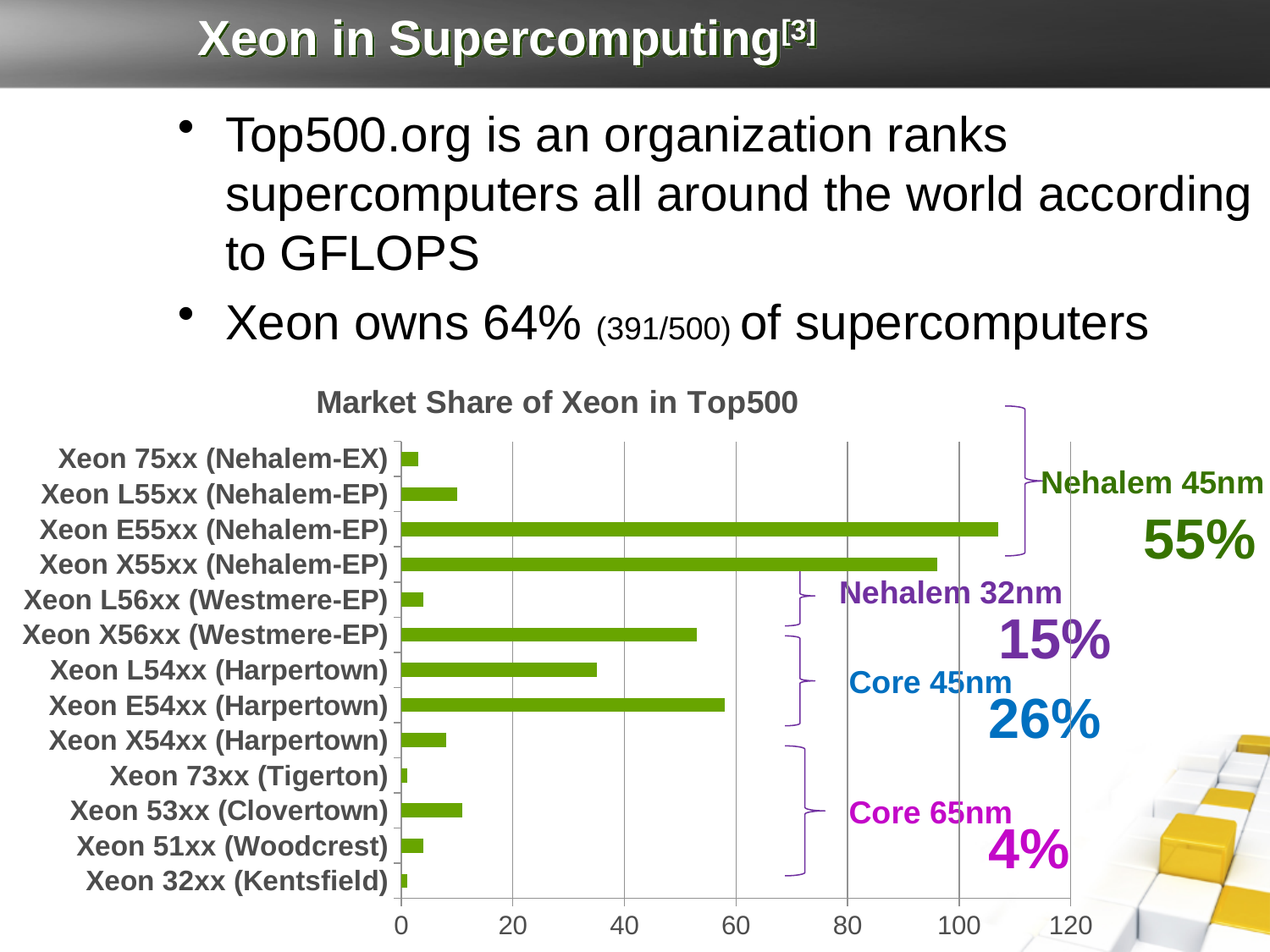
Is the value for Xeon X56xx (Westmere-EP) greater or less than 40? greater How many Xeon categories are plotted in the chart? 13 Is the value for Xeon L54xx (Harpertown) greater or less than 40? less What is the title of the chart? Market Share of Xeon in Top500 What kind of chart is shown on the slide? bar chart Which has a larger value, Xeon X55xx (Nehalem-EP) or Xeon X56xx (Westmere-EP)? Xeon X55xx (Nehalem-EP) Which has a larger value, Xeon E54xx (Harpertown) or Xeon L54xx (Harpertown)? Xeon E54xx (Harpertown) Which Xeon category has the highest value in the chart? Xeon E55xx (Nehalem-EP) Is the value for Xeon E54xx (Harpertown) greater or less than 40? greater What percentage is annotated next to the chart for the Nehalem 45nm group? 55%